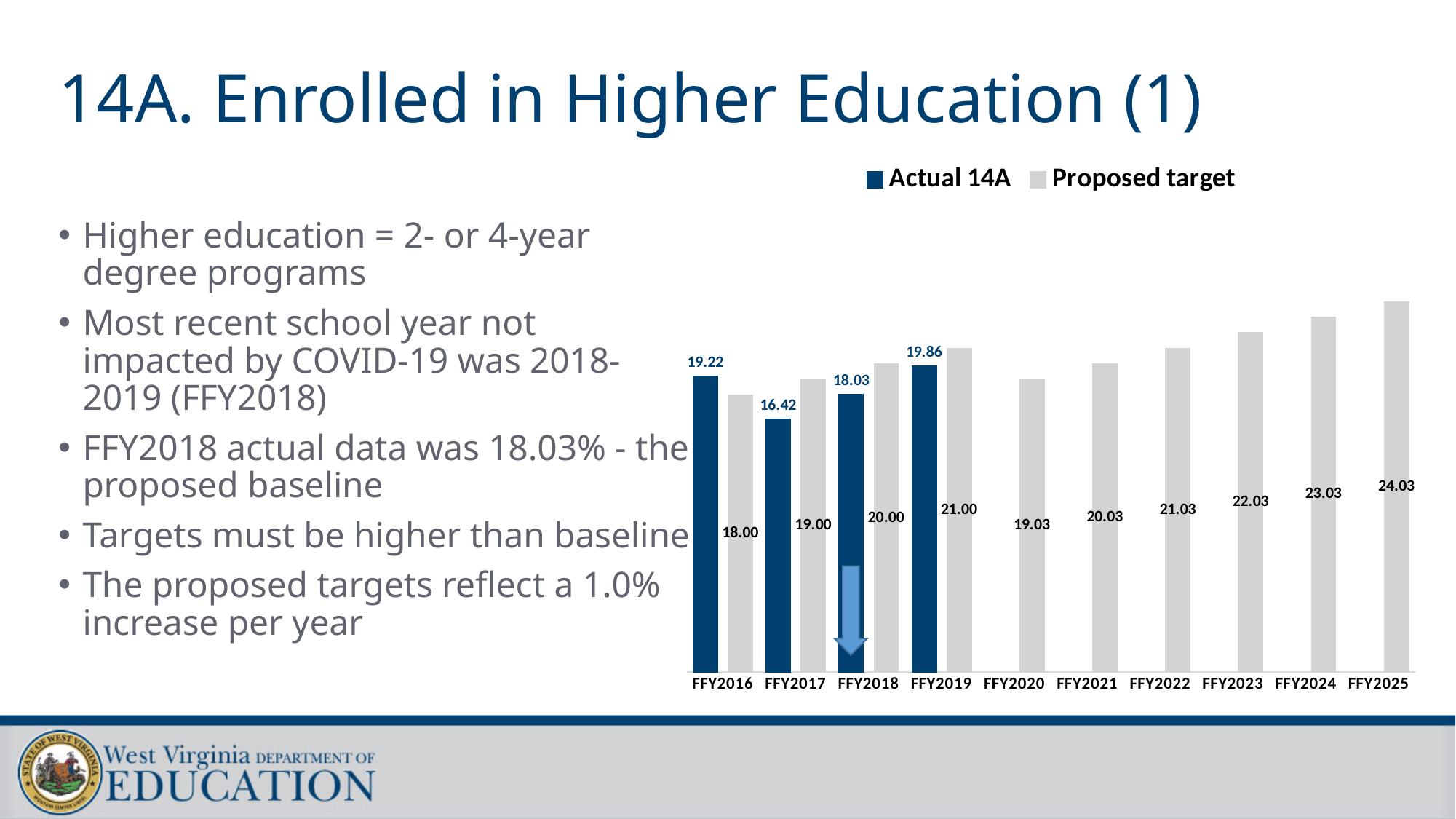
Do the Proposed target values rise or fall from FFY2020 to FFY2025? Rise What is the Actual 14A value for FFY2017? 16.42 What is the difference between the Actual 14A value for FFY2019 and FFY2018? 1.83 What is the Proposed target value for FFY2025? 24.03 What kind of chart is shown on the slide? Bar chart How many years are shown on the x axis of the chart? 10 Which year has the highest Actual 14A value? FFY2019 Which series is shown in dark blue in the chart legend? Actual 14A Which year has the lowest Actual 14A value? FFY2017 How many series does the chart legend list? 2 Which is larger for FFY2016, the Actual 14A value or the Proposed target? Actual 14A What is the Proposed target value for FFY2020? 19.03